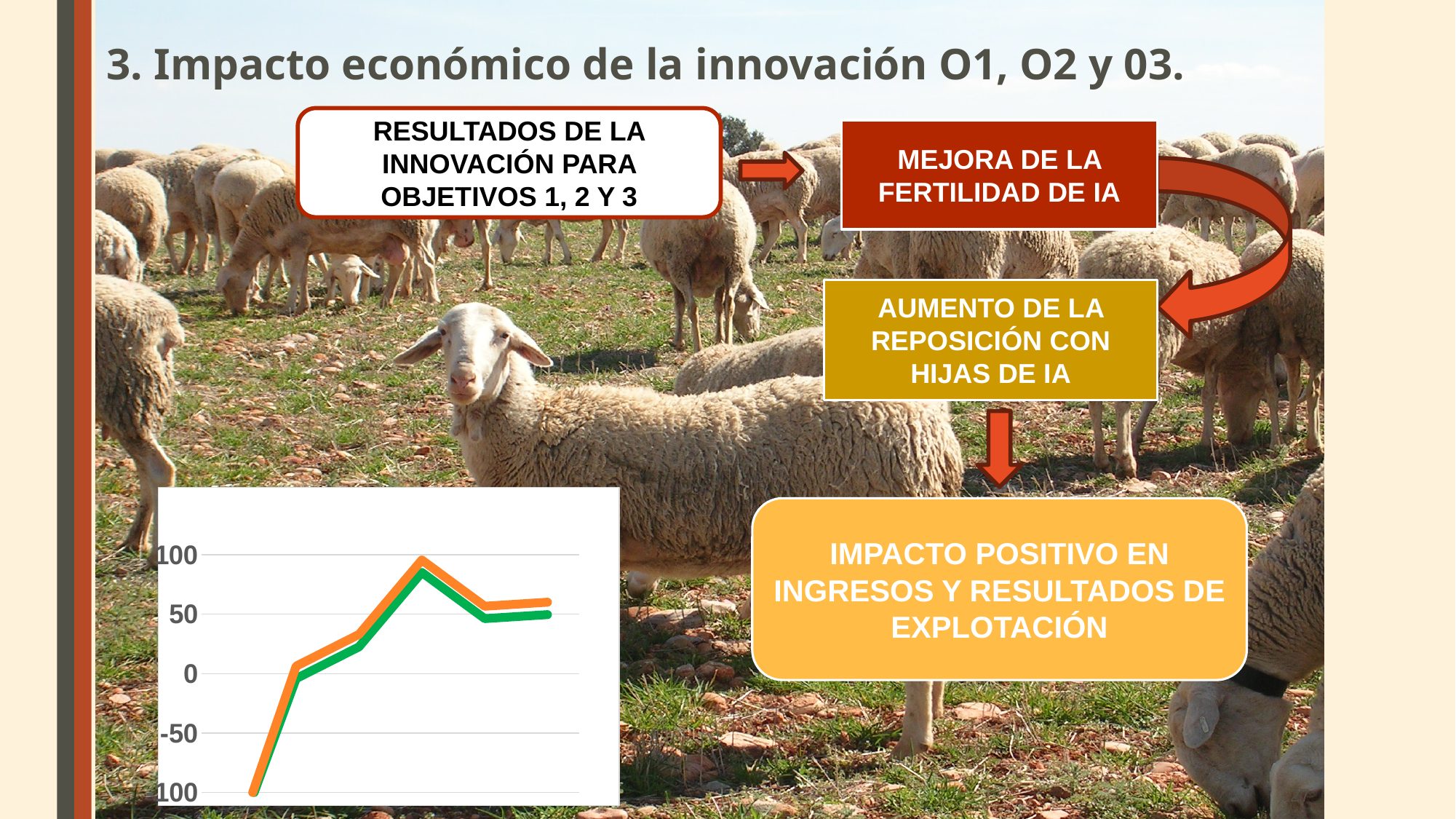
Which point along the x axis is the highest for the orange line: the first, second, third, fourth or fifth? fourth Is the value of the first point of the orange line greater or less than -50? less What kind of chart is shown at the bottom left of the slide? line chart Is the value of the first point of the green line greater or less than -50? less How many data points does each line in the chart have? 6 Which point along the x axis is the lowest for the green line: the first, second, third, fourth or fifth? first Is the highest point of the green line greater or less than 50? greater Do the lines in the chart rise or fall between the first and the fourth point? rise At the peak of the chart, which line is higher, the orange or the green? orange How many lines are plotted in the chart? 2